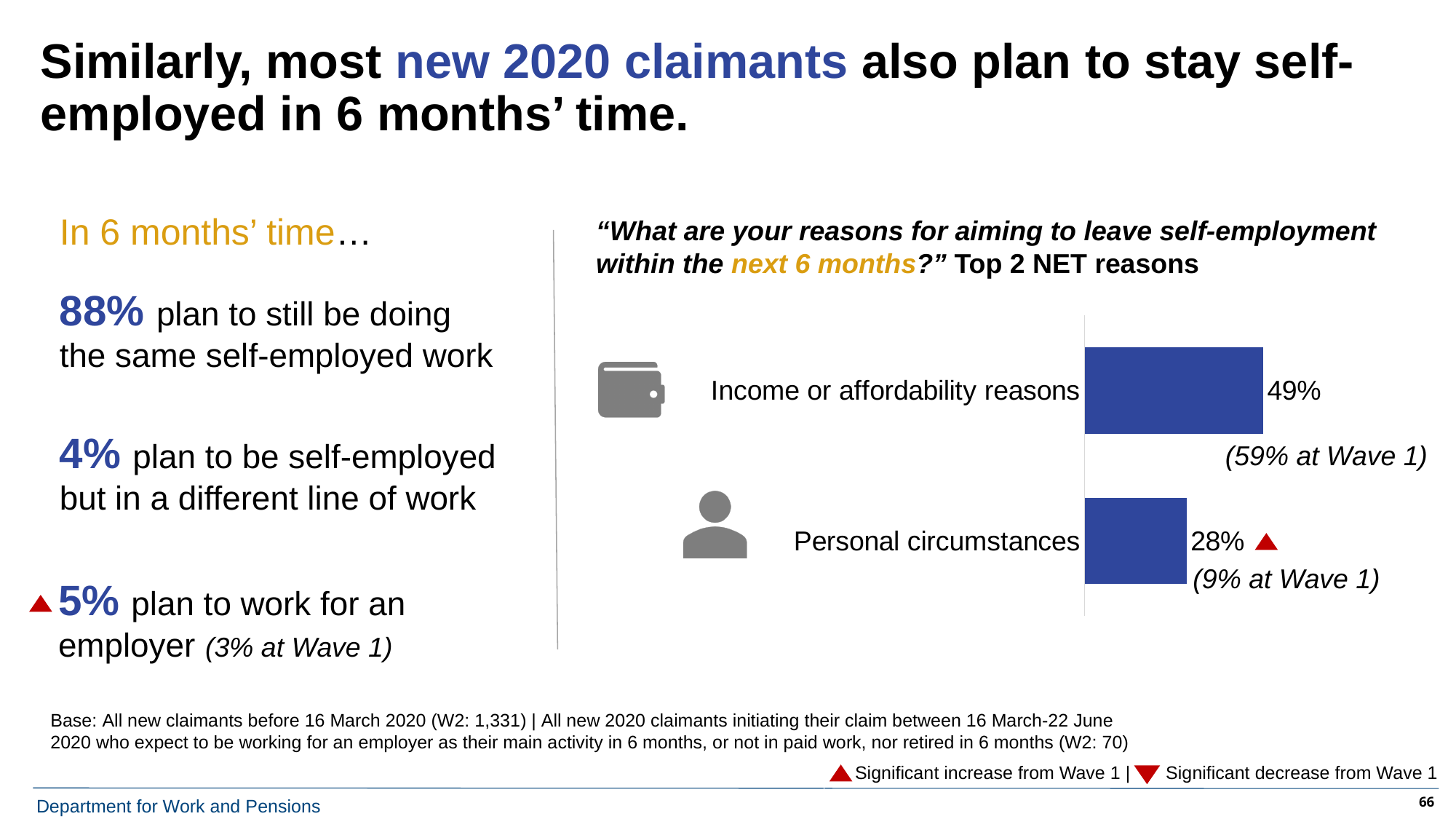
Which reason has the lowest value in the chart? Personal circumstances What colour are the bars in the chart? Blue What kind of chart is used to show the top 2 NET reasons? Bar chart Which is larger: the value for Income or affordability reasons or the value for Personal circumstances? Income or affordability reasons What percentage is shown for Income or affordability reasons? 49% What percentage is shown for Personal circumstances? 28% Which reason is marked with a red triangle indicating a significant increase from Wave 1? Personal circumstances What was the Wave 1 value for Income or affordability reasons, as noted on the chart? 59% Which reason has the highest value in the chart? Income or affordability reasons How many reasons are plotted in the chart? 2 What is the difference in percentage points between Income or affordability reasons and Personal circumstances? 21 What was the Wave 1 value for Personal circumstances, as noted on the chart? 9%